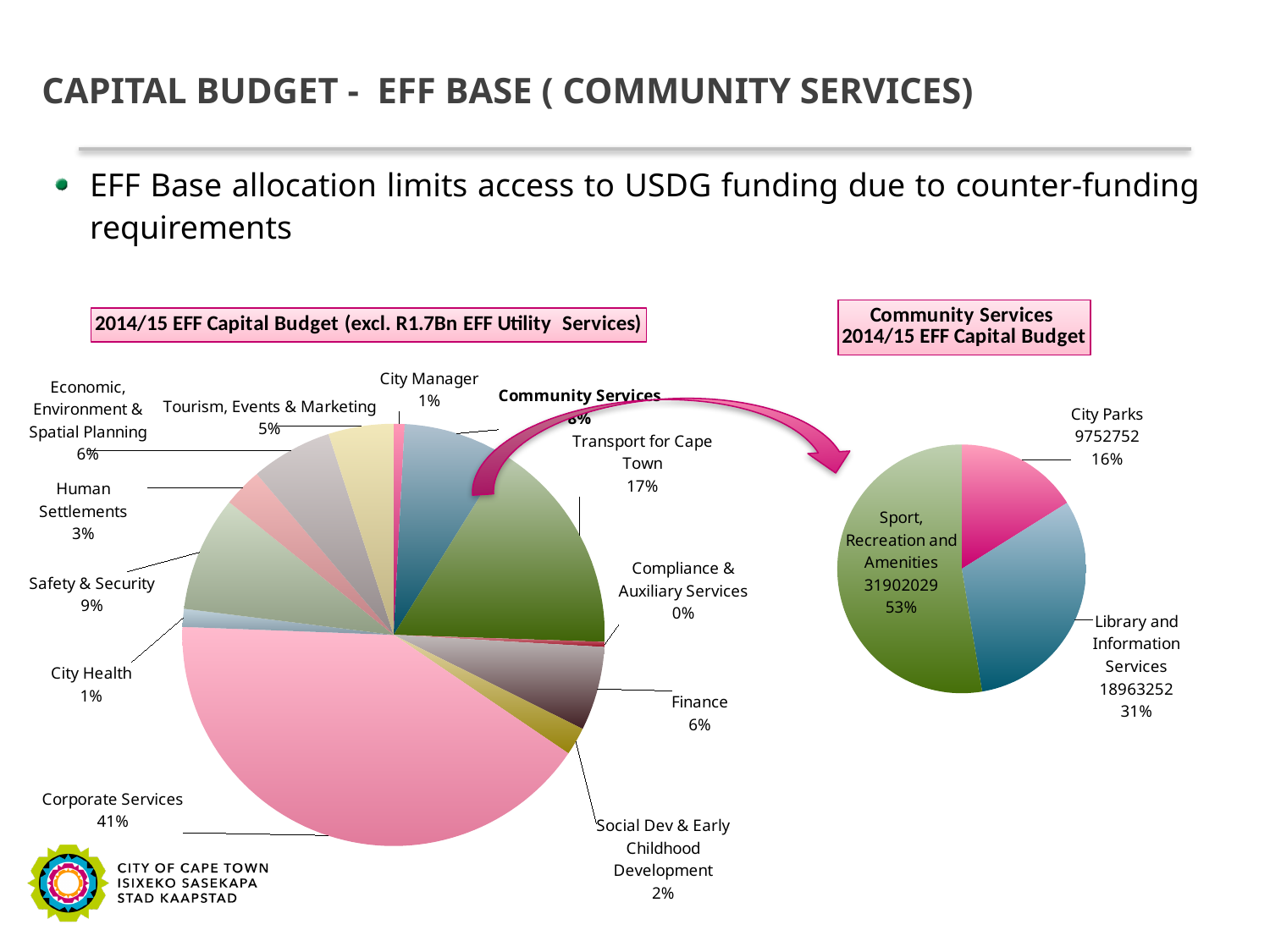
In the 2014/15 EFF Capital Budget chart, what share does Corporate Services have? 41% In the 2014/15 EFF Capital Budget chart, which category has the largest share? Corporate Services How many categories are shown in the 2014/15 EFF Capital Budget pie chart? 12 In the Community Services 2014/15 EFF Capital Budget chart, which category has the smallest share? City Parks How many categories are shown in the Community Services 2014/15 EFF Capital Budget pie chart? 3 In the Community Services 2014/15 EFF Capital Budget chart, what is the value for Library and Information Services? 18963252 What type of chart is the Community Services 2014/15 EFF Capital Budget chart? Pie chart In the 2014/15 EFF Capital Budget chart, which is larger: Safety & Security or Finance? Safety & Security In the 2014/15 EFF Capital Budget chart, what share does Transport for Cape Town have? 17% In the Community Services 2014/15 EFF Capital Budget chart, what share does Sport, Recreation and Amenities have? 53% In the 2014/15 EFF Capital Budget chart, which category has the smallest share? Compliance & Auxiliary Services In the 2014/15 EFF Capital Budget chart, what is the difference in percentage points between Corporate Services and Transport for Cape Town? 24